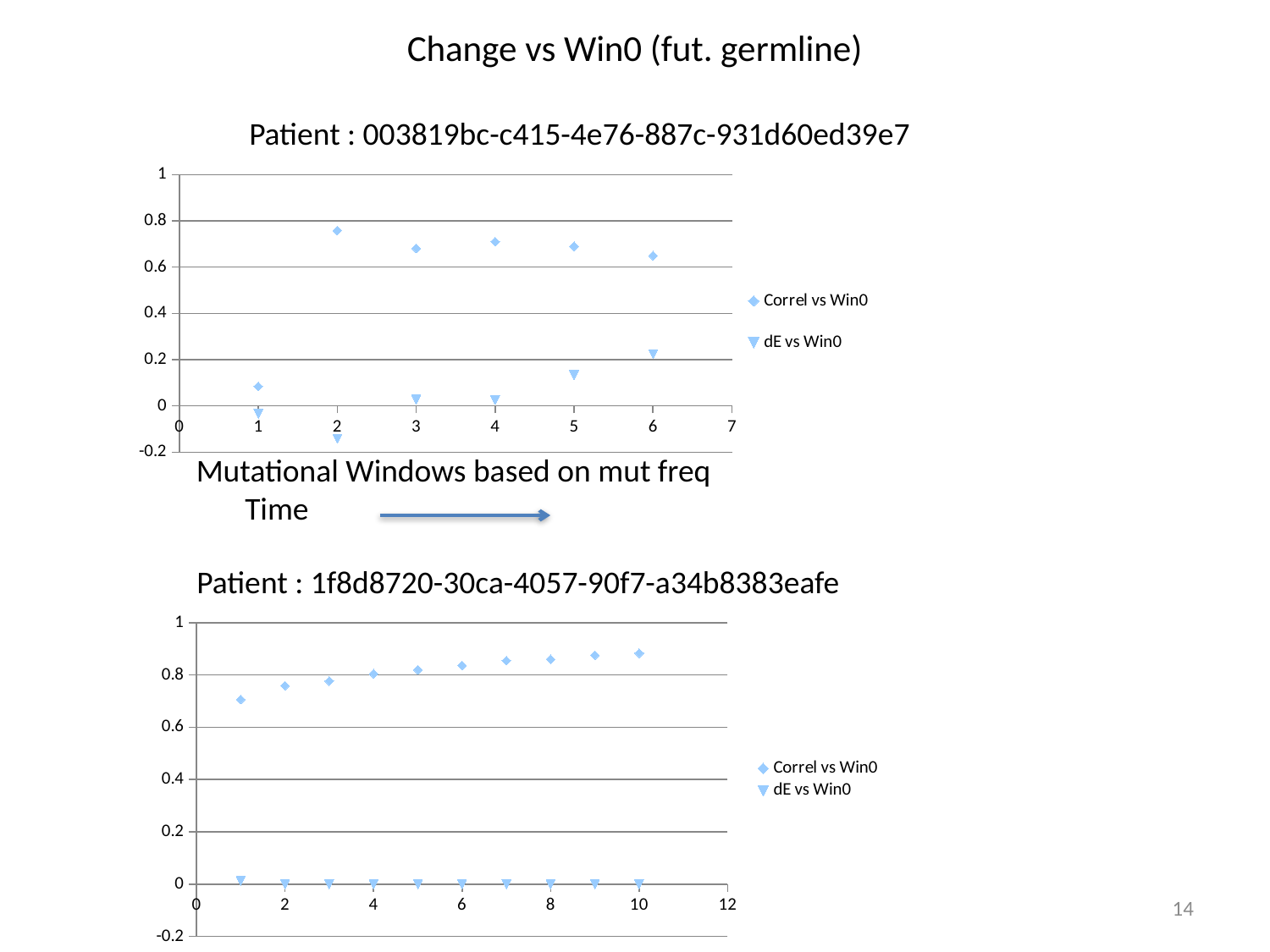
In the bottom chart (Patient 1f8d8720-30ca-4057-90f7-a34b8383eafe), how many points are plotted for the Correl vs Win0 series? 10 In the top chart (Patient 003819bc-c415-4e76-887c-931d60ed39e7), at which x value is the Correl vs Win0 series highest? 2 In the top chart (Patient 003819bc-c415-4e76-887c-931d60ed39e7), how many points are plotted for the Correl vs Win0 series? 6 In the bottom chart (Patient 1f8d8720-30ca-4057-90f7-a34b8383eafe), is the Correl vs Win0 value at x = 10 greater or less than 0.8? greater In the bottom chart (Patient 1f8d8720-30ca-4057-90f7-a34b8383eafe), do the Correl vs Win0 values rise or fall as x increases? rise In the top chart (Patient 003819bc-c415-4e76-887c-931d60ed39e7), is the dE vs Win0 value at x = 2 greater or less than 0? less What kind of chart is the top chart (Patient 003819bc-c415-4e76-887c-931d60ed39e7)? scatter chart What are the two legend entries of the bottom chart (Patient 1f8d8720-30ca-4057-90f7-a34b8383eafe)? Correl vs Win0 and dE vs Win0 How many series does the legend of the top chart (Patient 003819bc-c415-4e76-887c-931d60ed39e7) list? 2 In the top chart (Patient 003819bc-c415-4e76-887c-931d60ed39e7), at which x value is the Correl vs Win0 series lowest? 1 In the top chart (Patient 003819bc-c415-4e76-887c-931d60ed39e7), is the Correl vs Win0 value at x = 2 greater or less than 0.6? greater